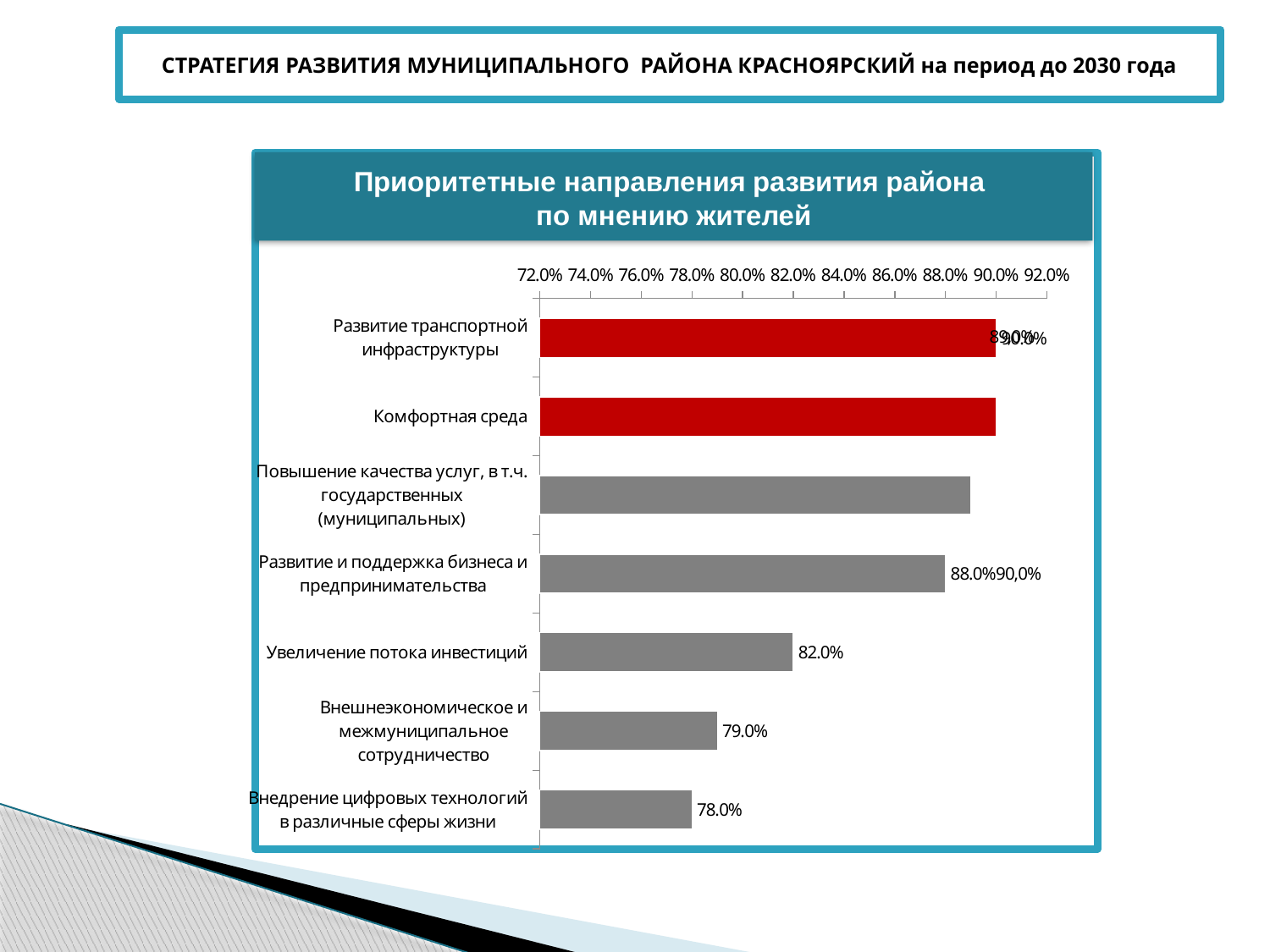
What is the difference between the values for Увеличение потока инвестиций and Внедрение цифровых технологий в различные сферы жизни? 4.0 percentage points What is the title of the chart? Приоритетные направления развития района по мнению жителей What is the value for Увеличение потока инвестиций? 82.0% What is the value for Внешнеэкономическое и межмуниципальное сотрудничество? 79.0% Which category has the lowest value? Внедрение цифровых технологий в различные сферы жизни Is the value for Комфортная среда greater or less than 86.0%? greater Which is larger: the value for Увеличение потока инвестиций or for Внешнеэкономическое и межмуниципальное сотрудничество? Увеличение потока инвестиций How many categories are shown in the chart? 7 Is the value for Повышение качества услуг, в т.ч. государственных (муниципальных) greater or less than 84.0%? greater What is the value for Внедрение цифровых технологий в различные сферы жизни? 78.0% What kind of chart is shown on the slide? bar chart What is the value for Развитие и поддержка бизнеса и предпринимательства? 88.0%